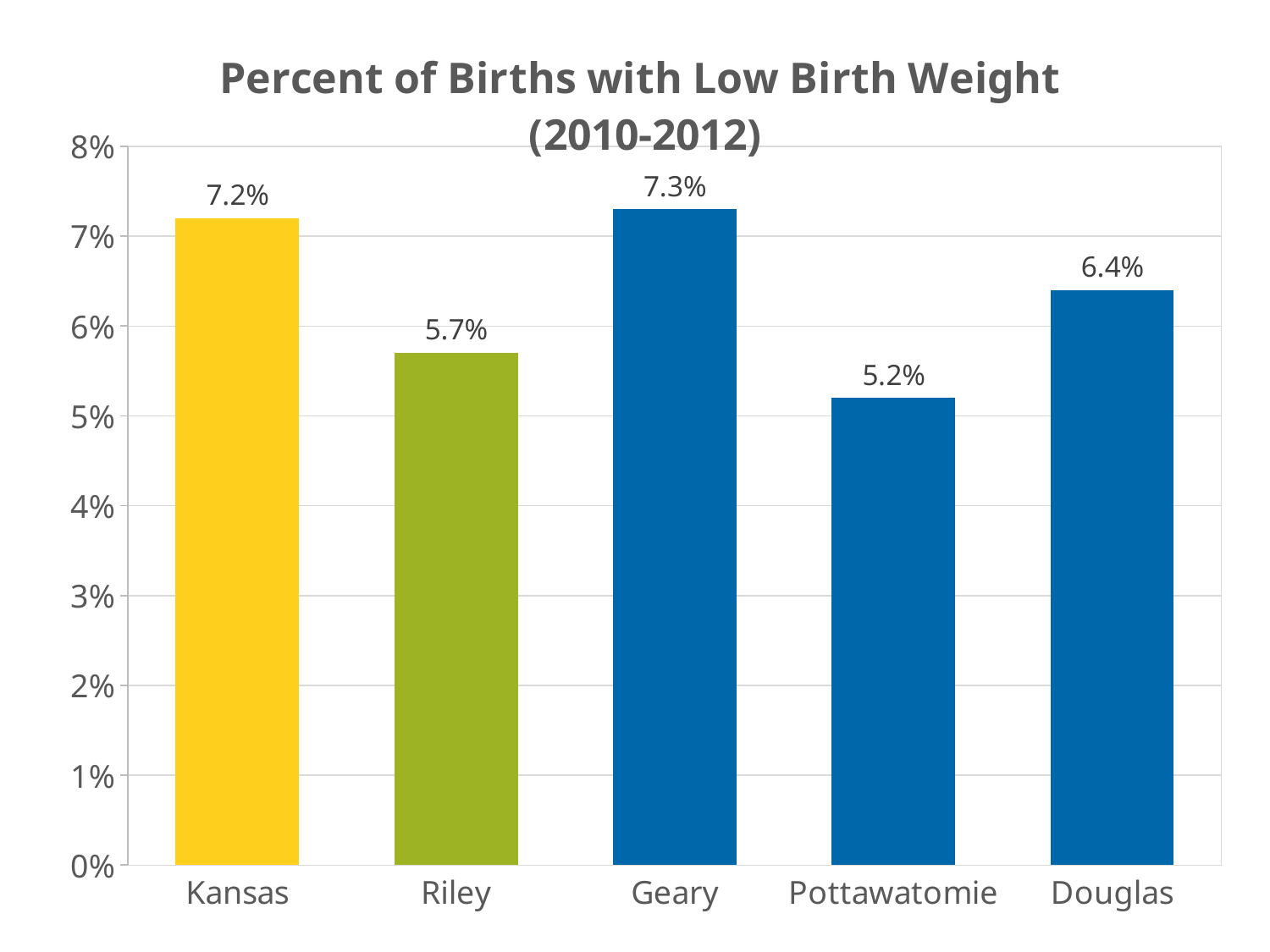
Which category has the lowest percent of births with low birth weight? Pottawatomie What is the percent of births with low birth weight for Kansas? 7.2% What is the difference between the values for Douglas and Pottawatomie? 1.2% Which has a larger value, Riley or Douglas? Douglas How many categories are shown on the chart? 5 What is the percent of births with low birth weight for Pottawatomie? 5.2% What is the percent of births with low birth weight for Douglas? 6.4% What is the percent of births with low birth weight for Riley? 5.7% Is the value for Geary greater or less than 7%? greater Which category has the highest percent of births with low birth weight? Geary What kind of chart is shown on the slide? Bar chart What is the difference between the values for Kansas and Riley? 1.5%